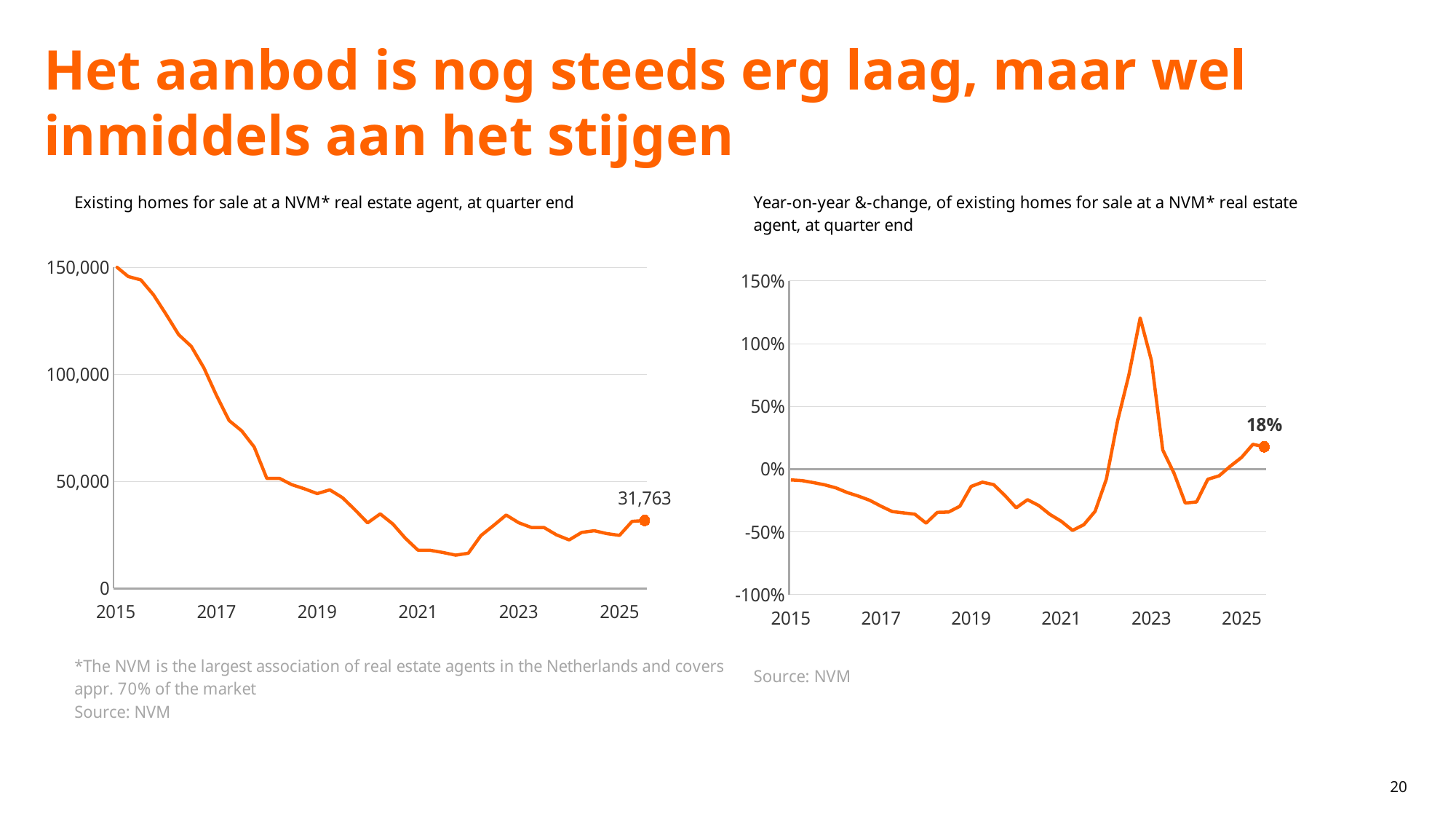
How many charts are shown on the slide? 2 In the left chart, do the values overall rise or fall between 2015 and 2019? fall What kind of chart is the left chart showing existing homes for sale? Line chart In the left chart (Existing homes for sale at a NVM real estate agent), what is the value shown for the latest data point? 31,763 In the right chart, is the peak value reached shortly before 2023 greater or less than 100%? greater What kind of chart is the right chart showing the year-on-year change? Line chart What source is cited for the charts on the slide? NVM In the left chart, is the value in 2021 greater or less than 50,000? less In the right chart, is the value in 2021 greater or less than 0%? less In the right chart (Year-on-year %-change of existing homes for sale), what is the value shown for the latest data point? 18% In the right chart, do the values rise or fall between 2024 and 2025? rise